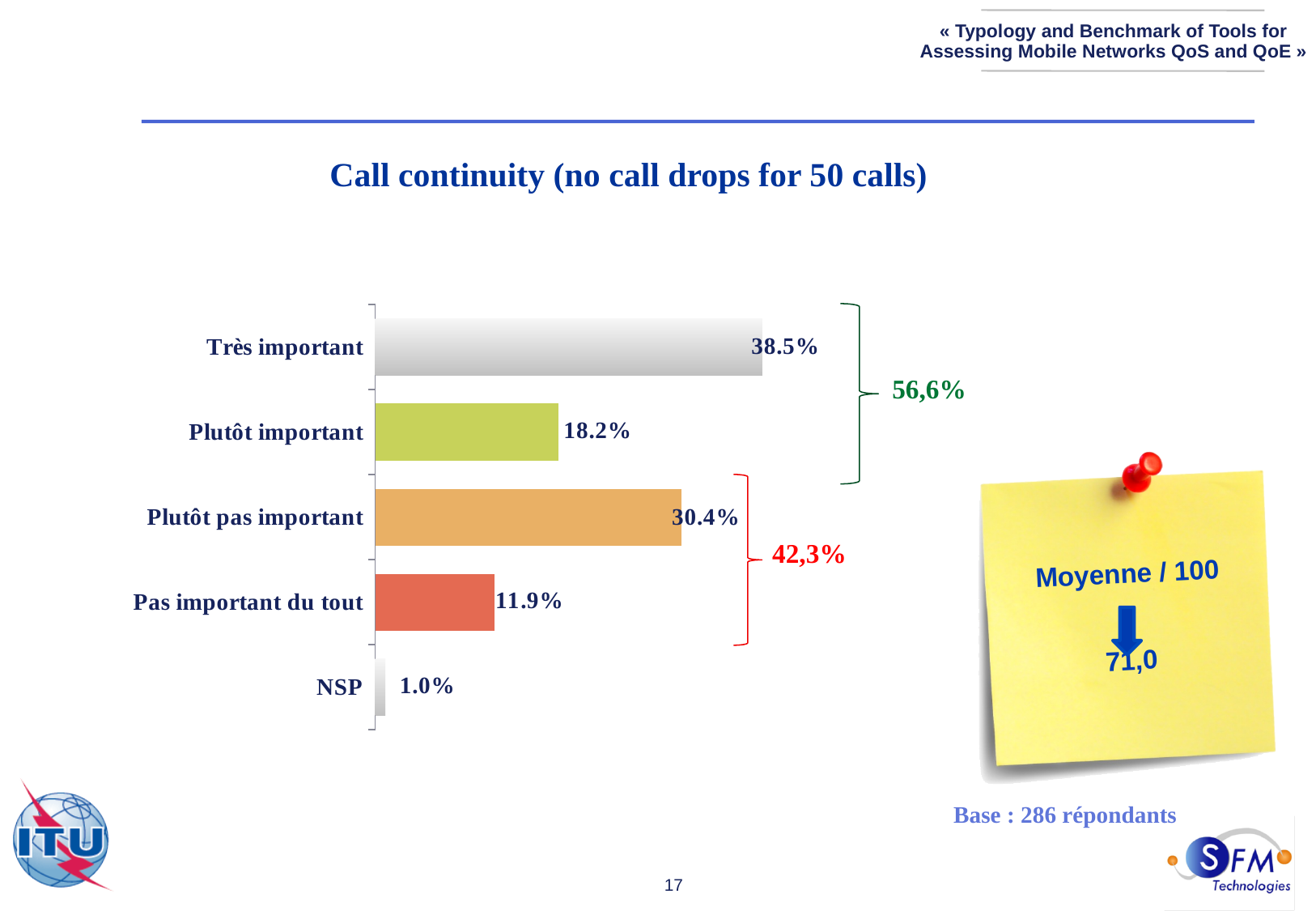
What is the value for "NSP"? 1.0% What is the value for "Très important"? 38.5% What is the value for "Plutôt pas important"? 30.4% What is the title of the chart? Call continuity (no call drops for 50 calls) Which is larger, the value for "Plutôt important" or the value for "Plutôt pas important"? Plutôt pas important What is the value for "Pas important du tout"? 11.9% What kind of chart is shown on the slide? Bar chart What combined percentage is shown by the bracket grouping "Plutôt pas important" and "Pas important du tout"? 42,3% How many categories are shown in the chart? 5 Which category has the lowest value? NSP What is the difference between the values for "Très important" and "Plutôt important"? 20.3% Which category has the highest value? Très important